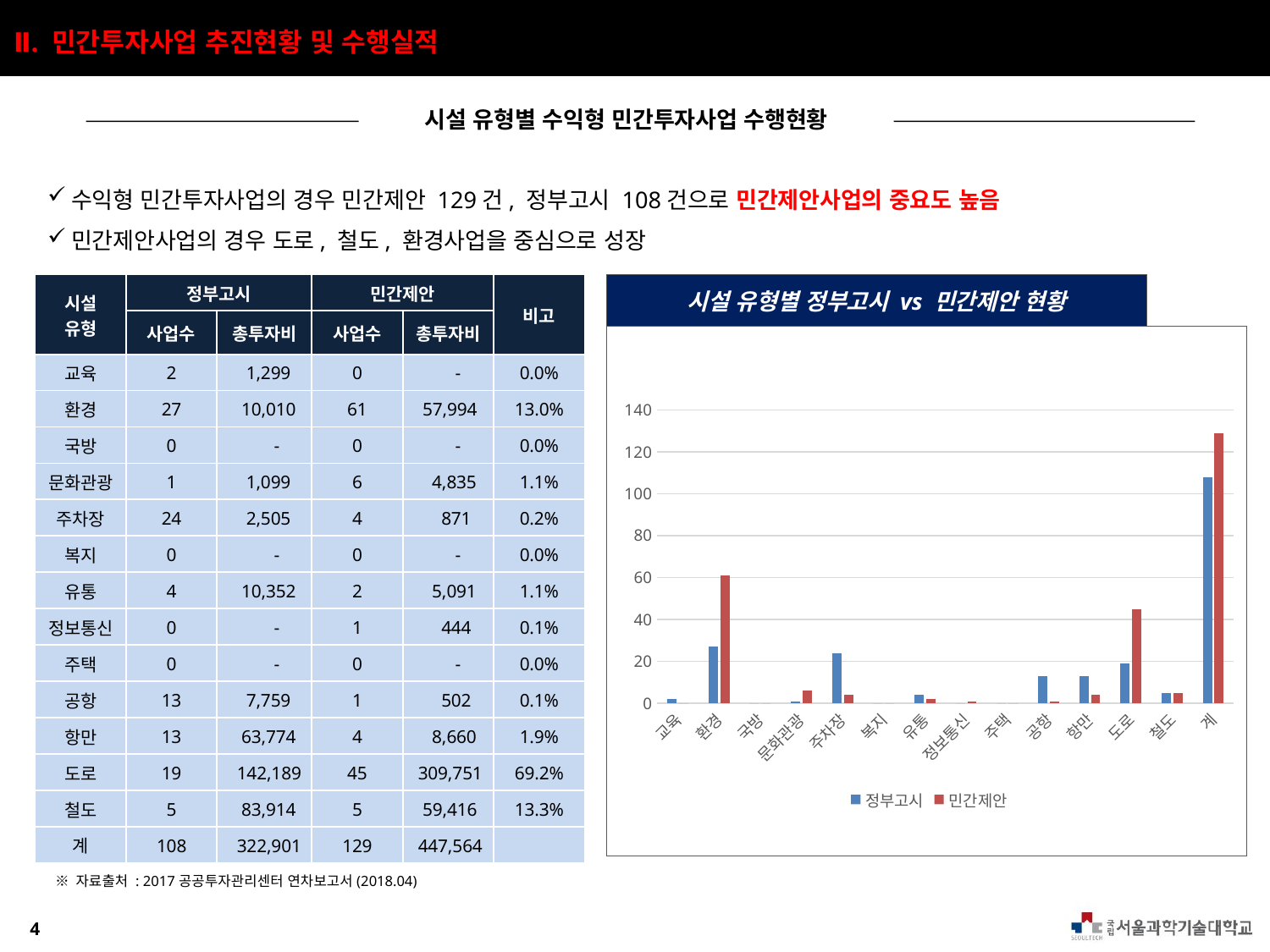
Which category has the tallest bar overall in the chart? 계 Is the 민간제안 value for 환경 greater or less than 40? greater How many categories are shown along the x axis of the chart? 14 Excluding 계, which category has the highest 민간제안 bar? 환경 Is the 정부고시 value for 계 greater or less than 100? greater For 도로, which series has the larger bar, 정부고시 or 민간제안? 민간제안 What kind of chart is shown on the slide? bar chart For 주차장, which series has the larger bar, 정부고시 or 민간제안? 정부고시 How many series does the chart legend list? 2 Is the 민간제안 value for 계 greater or less than 120? greater Which colour represents the 민간제안 series in the chart? red What is the title of the chart? 시설 유형별 정부고시 vs 민간제안 현황